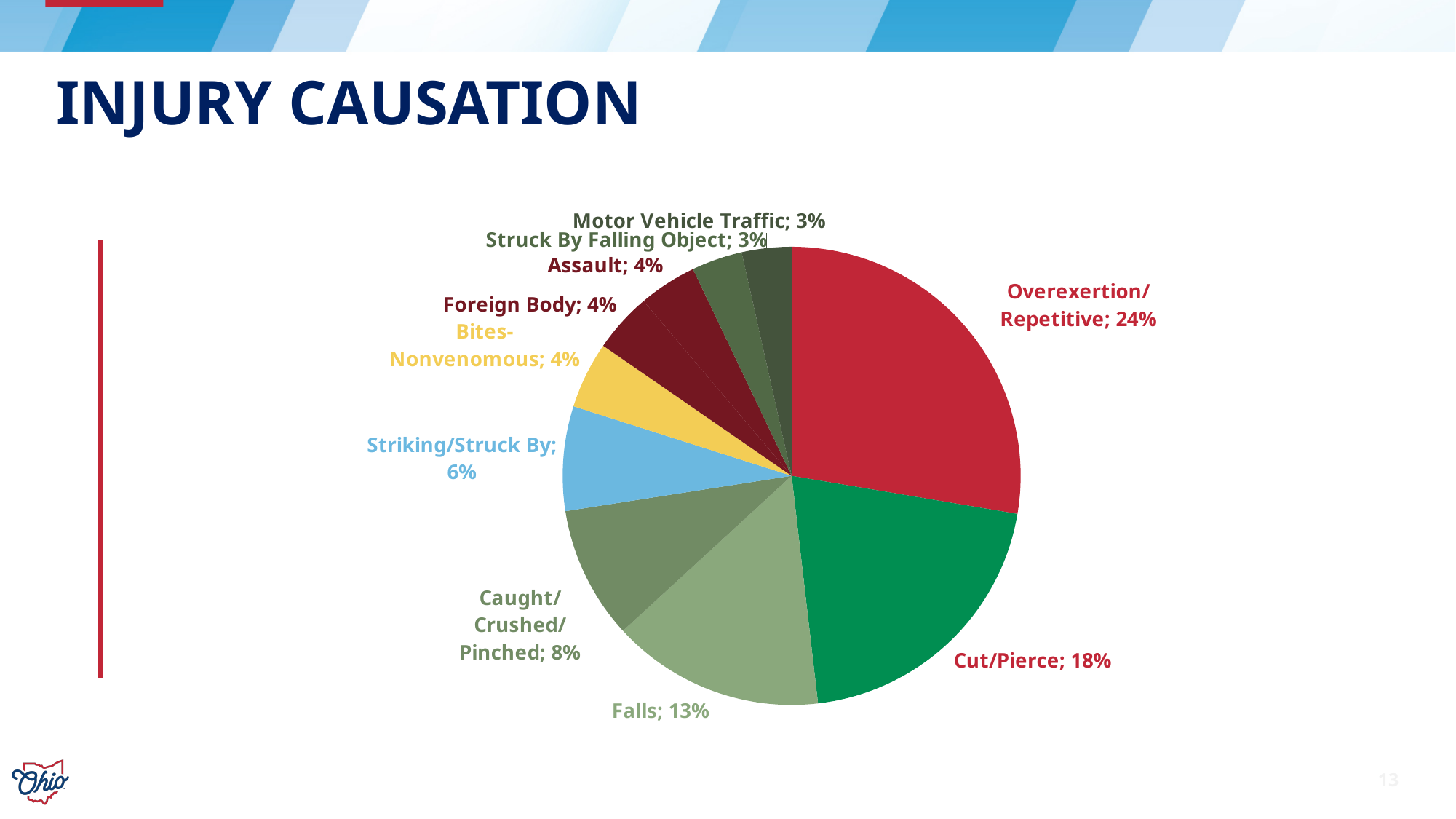
What kind of chart is shown on the slide? Pie chart What is the value shown for Falls? 13% Which injury cause has the largest slice of the pie? Overexertion/Repetitive What percentage is shown for Caught/Crushed/Pinched? 8% What percentage of the pie is Cut/Pierce? 18% How many slices does the pie chart have? 10 What is the difference in percentage points between Overexertion/Repetitive and Cut/Pierce? 6 percentage points What is the value for Striking/Struck By? 6% What percentage is shown for Motor Vehicle Traffic? 3% Which is larger, Falls or Caught/Crushed/Pinched? Falls What is the title of the slide containing the chart? INJURY CAUSATION What share of injuries is attributed to Overexertion/Repetitive? 24%